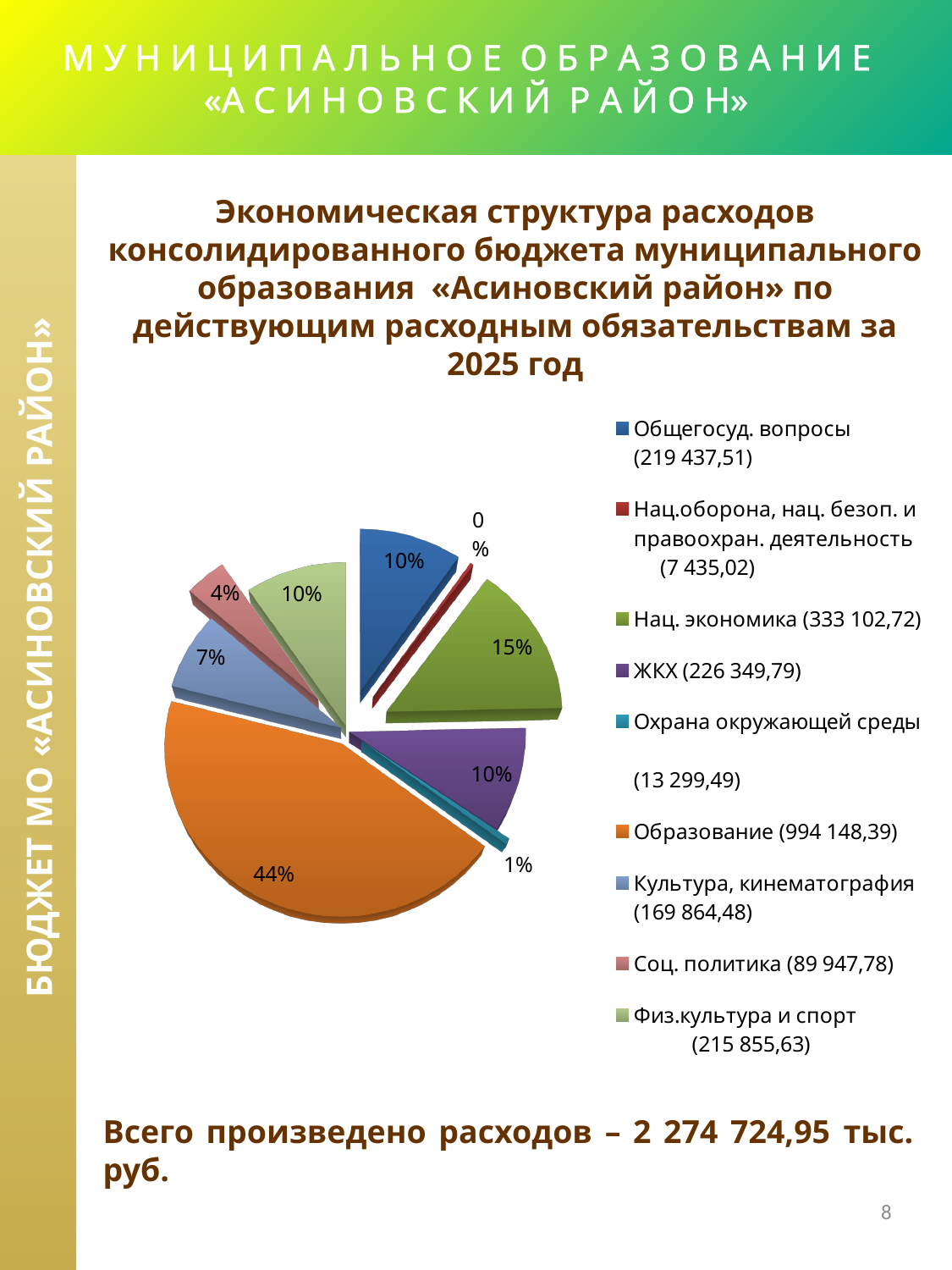
What percentage is shown for Нац. экономика? 15% What share of the pie does Образование account for? 44% What is the difference in percentage points between the shares of Образование and Нац. экономика? 29% What value is given in the legend for Образование? 994 148,39 How many categories does the legend of the pie chart list? 9 Which category has the smallest share of the pie? Нац.оборона, нац. безоп. и правоохран. деятельность What kind of chart is shown on the slide? pie chart Which is larger: the share for Нац. экономика or the share for ЖКХ? Нац. экономика What percentage is shown for Соц. политика? 4% Which category has the largest share of the pie? Образование What total expenditure is stated below the chart? 2 274 724,95 тыс. руб. What percentage is shown for Культура, кинематография? 7%